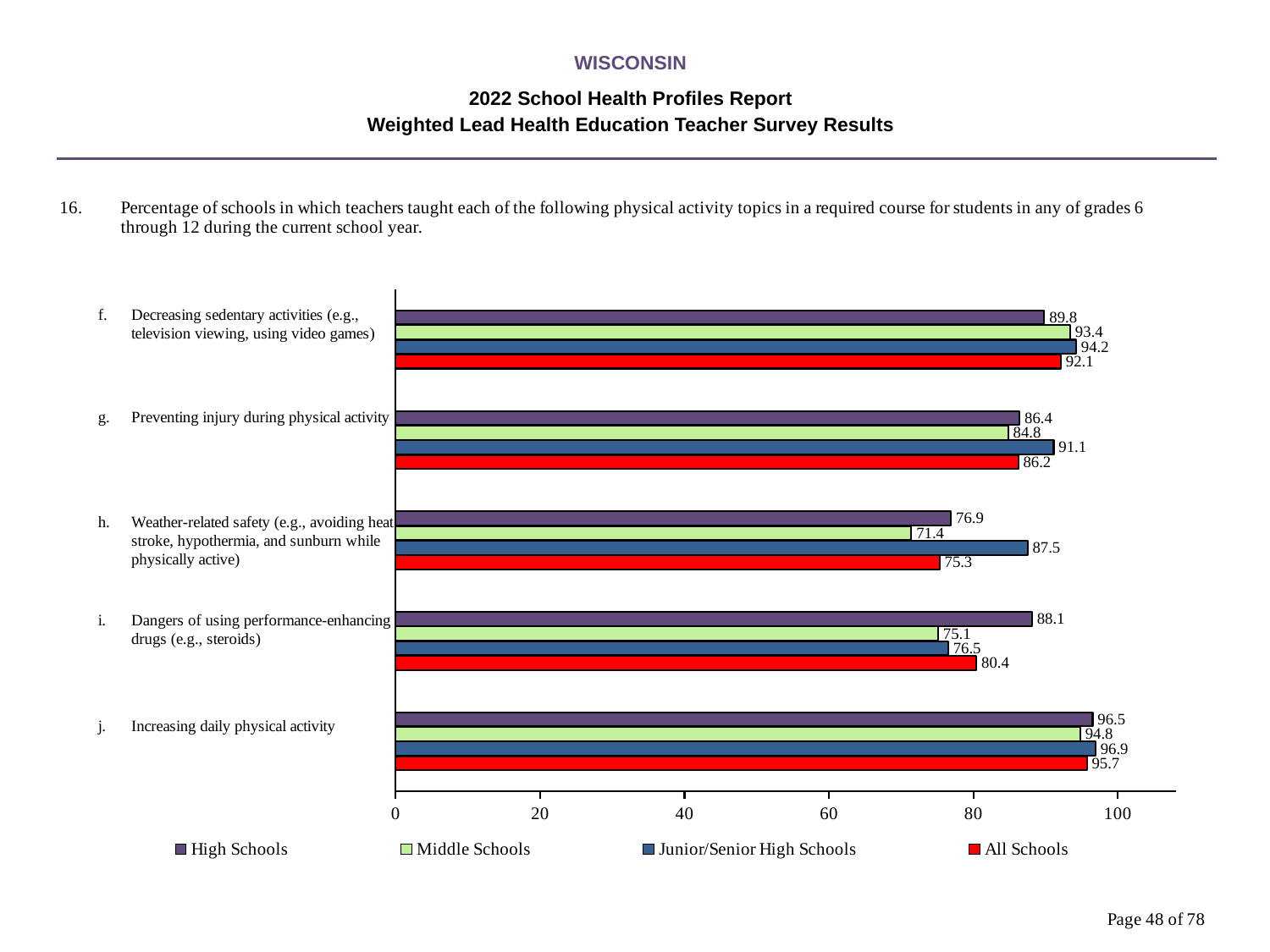
What kind of chart is shown on the slide? bar chart How many series does the legend list? 4 Is the All Schools value for 'Weather-related safety' greater or less than 80? less Which topic has the lowest value for Middle Schools? Weather-related safety How many topics are shown on the chart? 5 What is the value for Junior/Senior High Schools for 'Preventing injury during physical activity'? 91.1 What is the value for Middle Schools for 'Weather-related safety'? 71.4 Which topic has the highest value for All Schools? Increasing daily physical activity For 'Weather-related safety', which is larger: the High Schools value or the Junior/Senior High Schools value? Junior/Senior High Schools What is the value for High Schools for 'Increasing daily physical activity'? 96.5 What is the difference between the High Schools and Middle Schools values for 'Dangers of using performance-enhancing drugs'? 13.0 What is the value for All Schools for 'Dangers of using performance-enhancing drugs'? 80.4